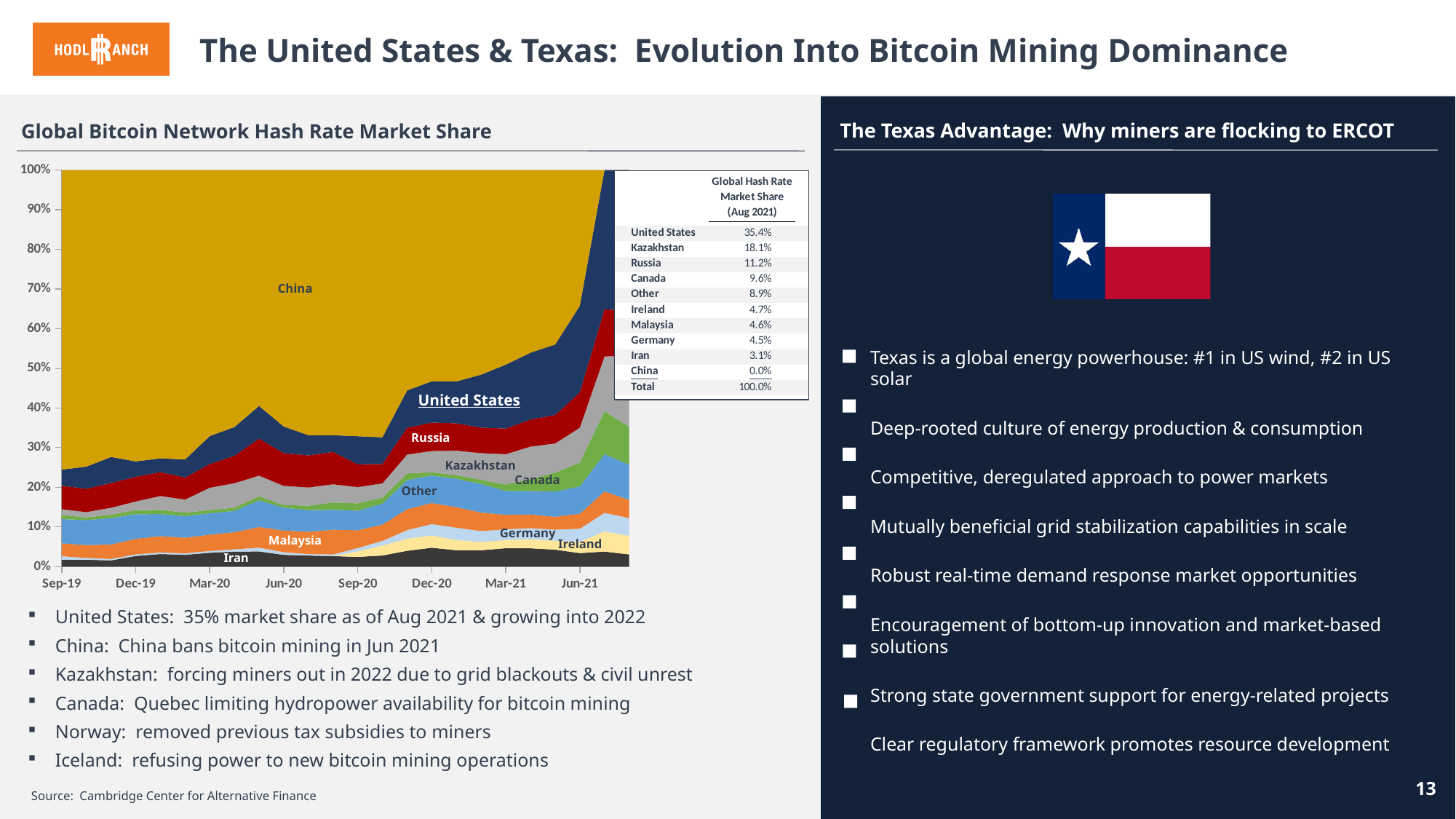
What is the first date label on the x axis of the hash rate chart? Sep-19 According to the inset table, what was Canada's global hash rate market share in Aug 2021? 9.6% Which country had the lowest global hash rate market share in Aug 2021 according to the inset table? China What is the difference between the United States' and Kazakhstan's hash rate market share in Aug 2021 according to the inset table? 17.3% Which country had the highest global hash rate market share in Aug 2021 according to the inset table? United States According to the inset table, what was Kazakhstan's global hash rate market share in Aug 2021? 18.1% According to the inset table, what was China's global hash rate market share in Aug 2021? 0.0% In Aug 2021, which had a larger hash rate market share according to the inset table: Russia or Canada? Russia How many countries/regions (excluding Total) are listed in the inset table of the hash rate chart? 10 According to the inset table, what was the United States' global hash rate market share in Aug 2021? 35.4% What kind of chart is the Global Bitcoin Network Hash Rate Market Share chart? Stacked area chart How does China's share of the global hash rate change across the chart from Sep-19 to Jun-21? It falls